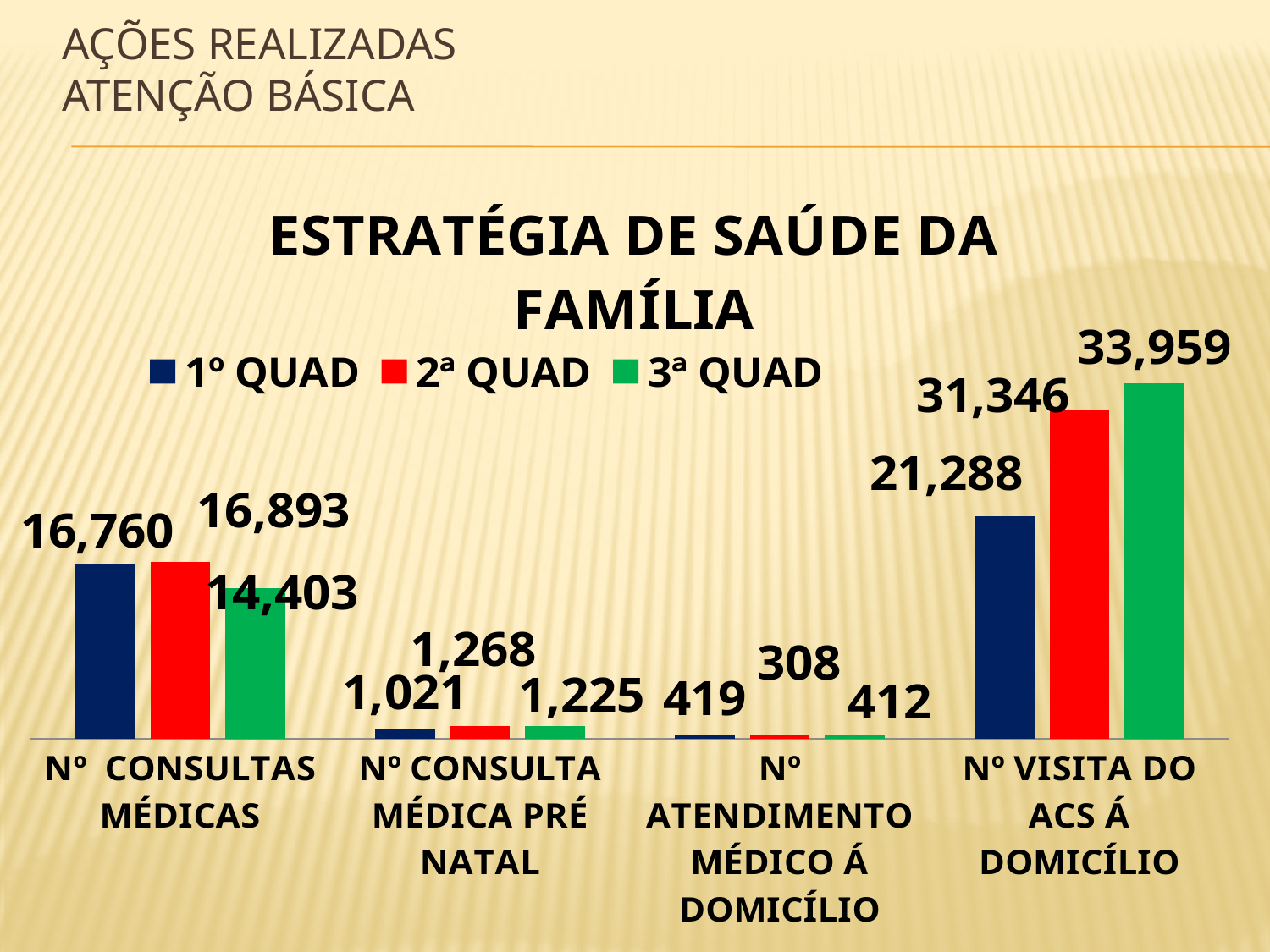
What is the value for 3ª QUAD in the Nº VISITA DO ACS Á DOMICÍLIO category? 33,959 What is the difference between the 2ª QUAD and 1º QUAD values for Nº VISITA DO ACS Á DOMICÍLIO? 10,058 Which category has the lowest value for 1º QUAD? Nº ATENDIMENTO MÉDICO Á DOMICÍLIO What is the value for 2ª QUAD in the Nº CONSULTA MÉDICA PRÉ NATAL category? 1,268 Which category has the highest value for 3ª QUAD? Nº VISITA DO ACS Á DOMICÍLIO How many categories are shown on the x axis? 4 What is the value for 1º QUAD in the Nº CONSULTAS MÉDICAS category? 16,760 What kind of chart is shown on the slide? Bar chart What is the difference between the 2ª QUAD and 3ª QUAD values for Nº CONSULTAS MÉDICAS? 2,490 In the Nº ATENDIMENTO MÉDICO Á DOMICÍLIO category, which is larger: the 1º QUAD value or the 3ª QUAD value? 1º QUAD How many series does the legend list? 3 What is the value for 2ª QUAD in the Nº ATENDIMENTO MÉDICO Á DOMICÍLIO category? 308